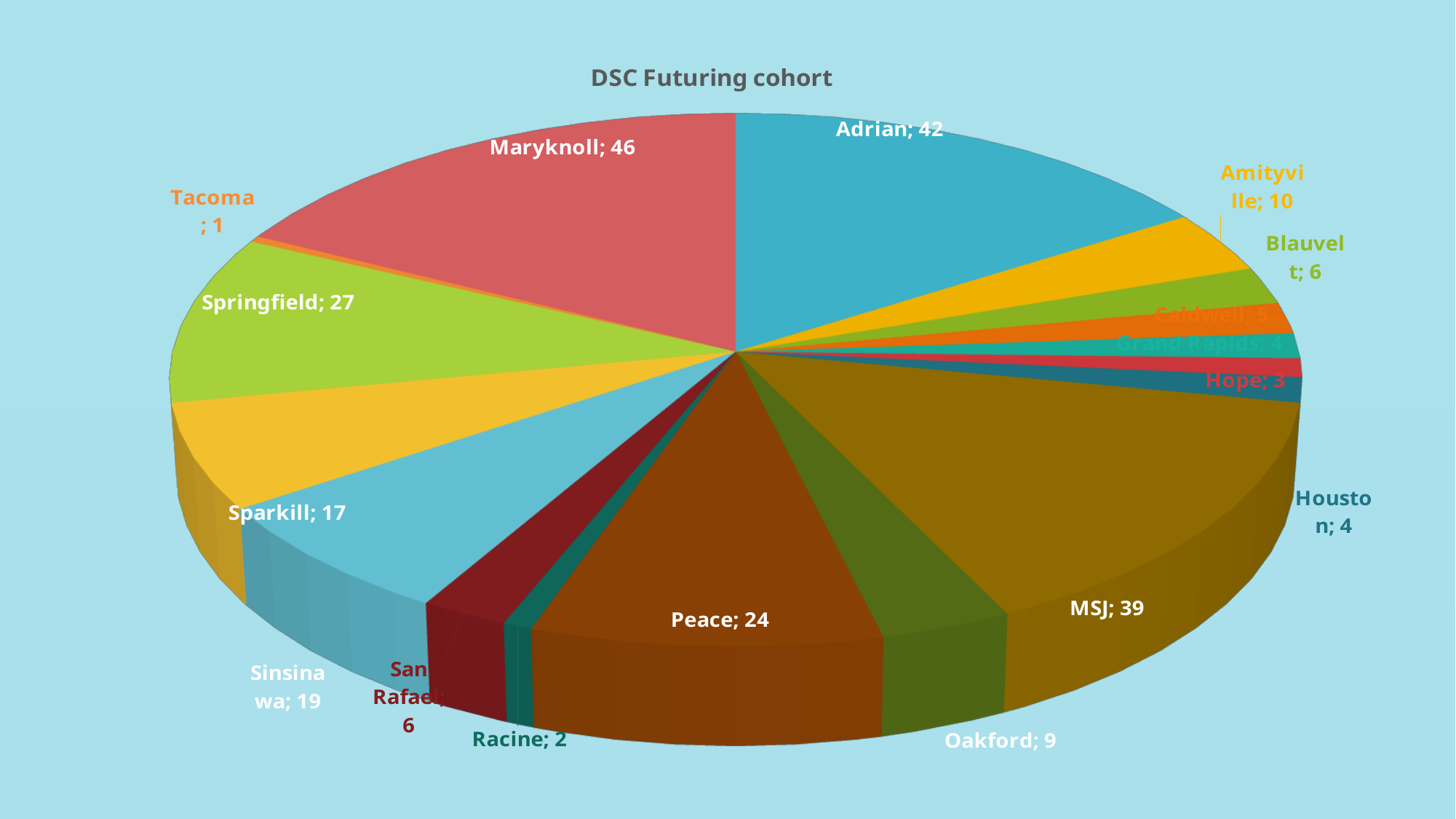
What is the difference between the values for Springfield and Sinsinawa? 8 What is the title of the chart? DSC Futuring cohort Which category has the smallest slice? Tacoma What is the value for Peace? 24 What is the value for Sparkill? 17 What kind of chart is shown on the slide? Pie chart How many categories are shown in the chart? 17 What is the value for Adrian? 42 What is the value for Maryknoll? 46 Which category has the largest slice? Maryknoll What is the difference between the values for Maryknoll and Adrian? 4 Which is larger, the value for MSJ or the value for Springfield? MSJ